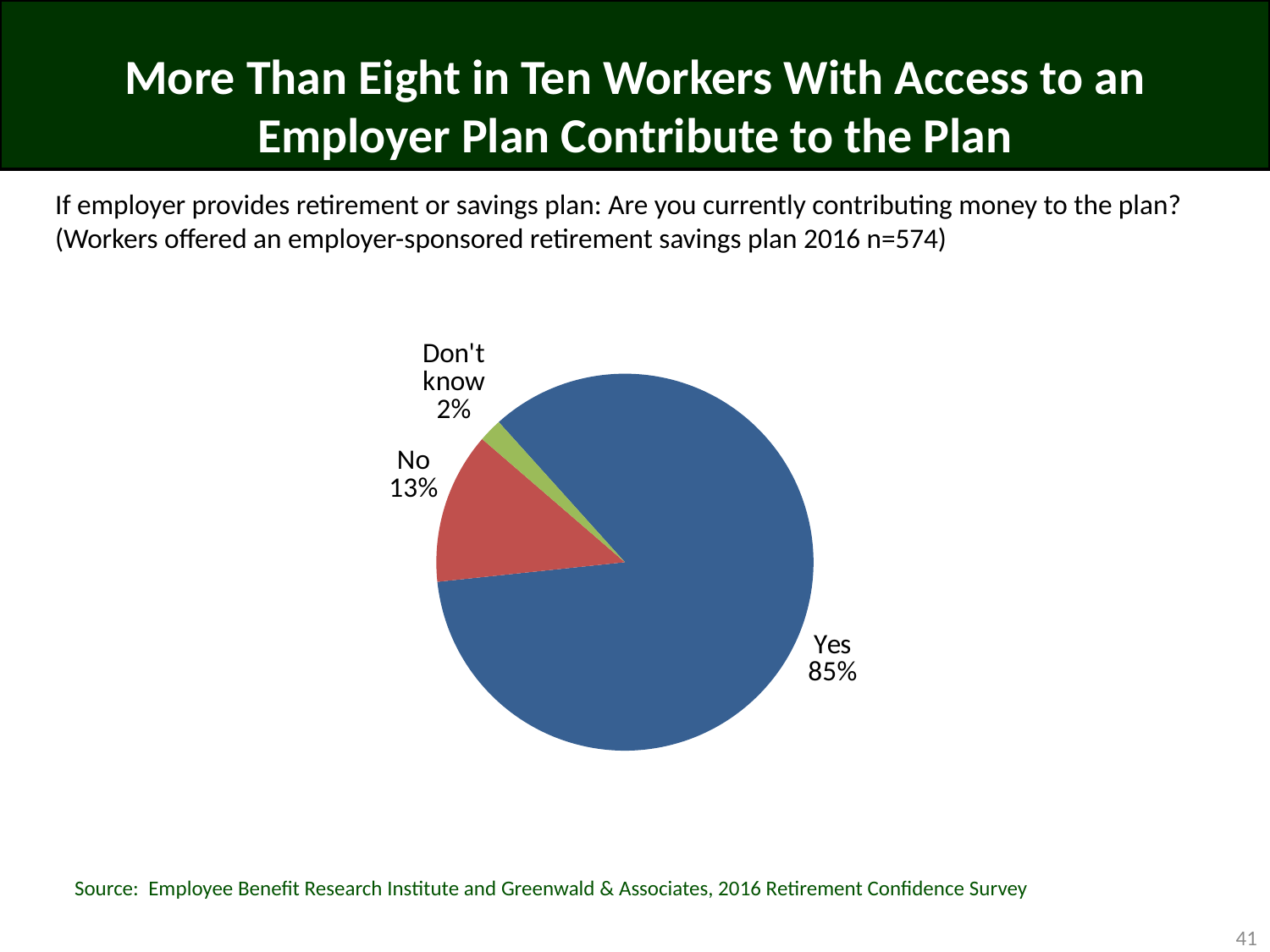
Which response has the smallest share of the pie? Don't know What is the difference in percentage points between the "Yes" and "No" slices? 72 Which response has the largest share of the pie? Yes How many slices does the pie chart have? 3 What is the difference in percentage points between the "No" and "Don't know" slices? 11 What percentage of workers answered "Don't know"? 2% What is the sample size (n) stated for the survey question on the slide? 574 What colour is the "Yes" slice of the pie? Blue Which is larger, the "No" slice or the "Don't know" slice? No What percentage of workers answered "Yes" to currently contributing money to the plan? 85% What percentage of workers answered "No"? 13% What kind of chart is shown on the slide? Pie chart